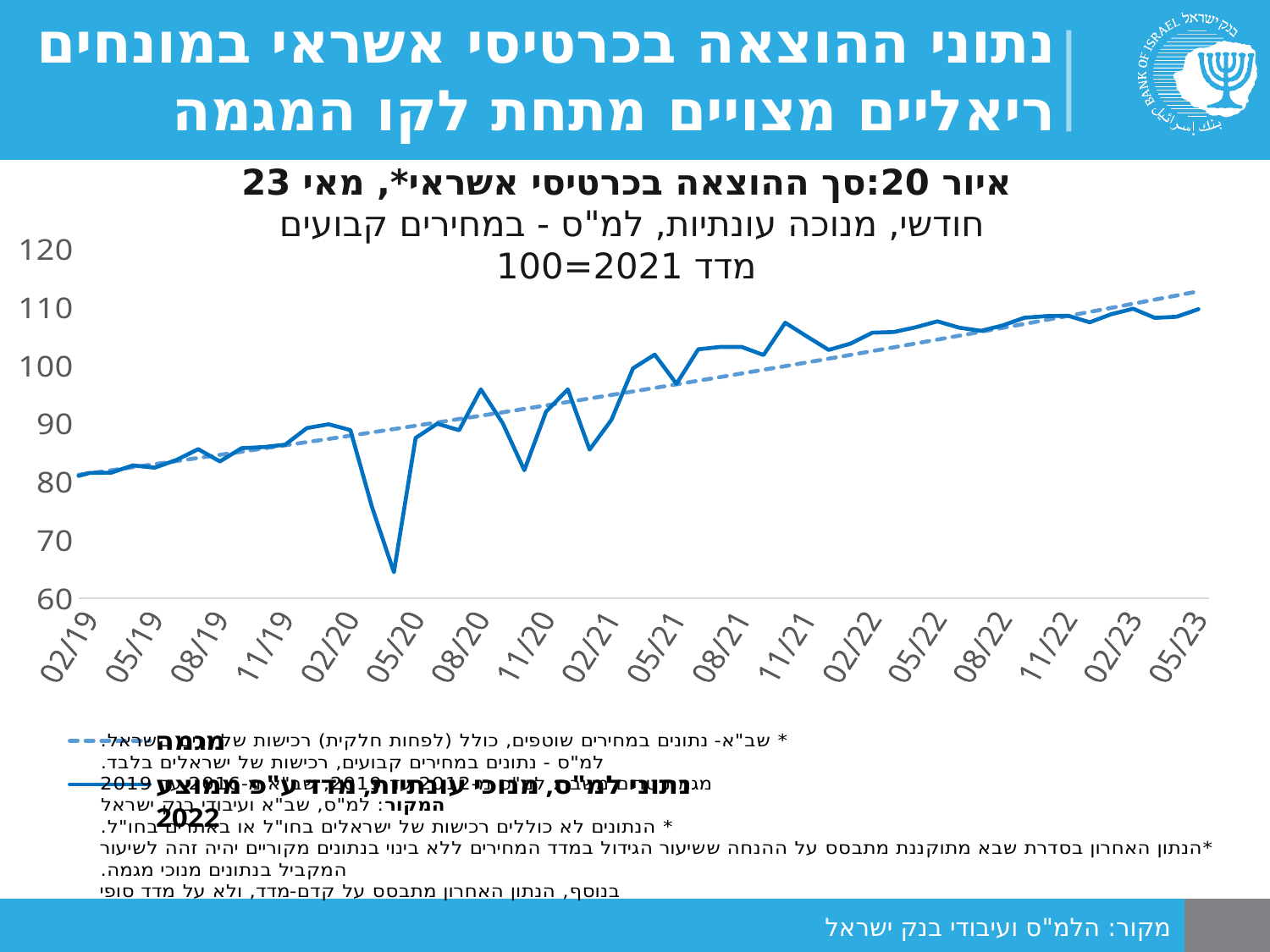
Which is larger, the value of the solid line at 05/23 or at 02/19? 05/23 In which year does the solid line reach its lowest point? 2020 What kind of chart is shown on the slide? line chart What is the first date label on the x axis? 02/19 Is the value of the solid line at 02/19 greater or less than 90? less What is the highest value shown on the y axis? 120 Is the lowest value of the solid line greater or less than 70? less How many date labels are shown along the x axis? 18 Is the value of the solid line at 05/23 greater or less than 100? greater Do the values of the solid line generally rise or fall from 02/19 to 05/23? rise How many series does the legend list? 2